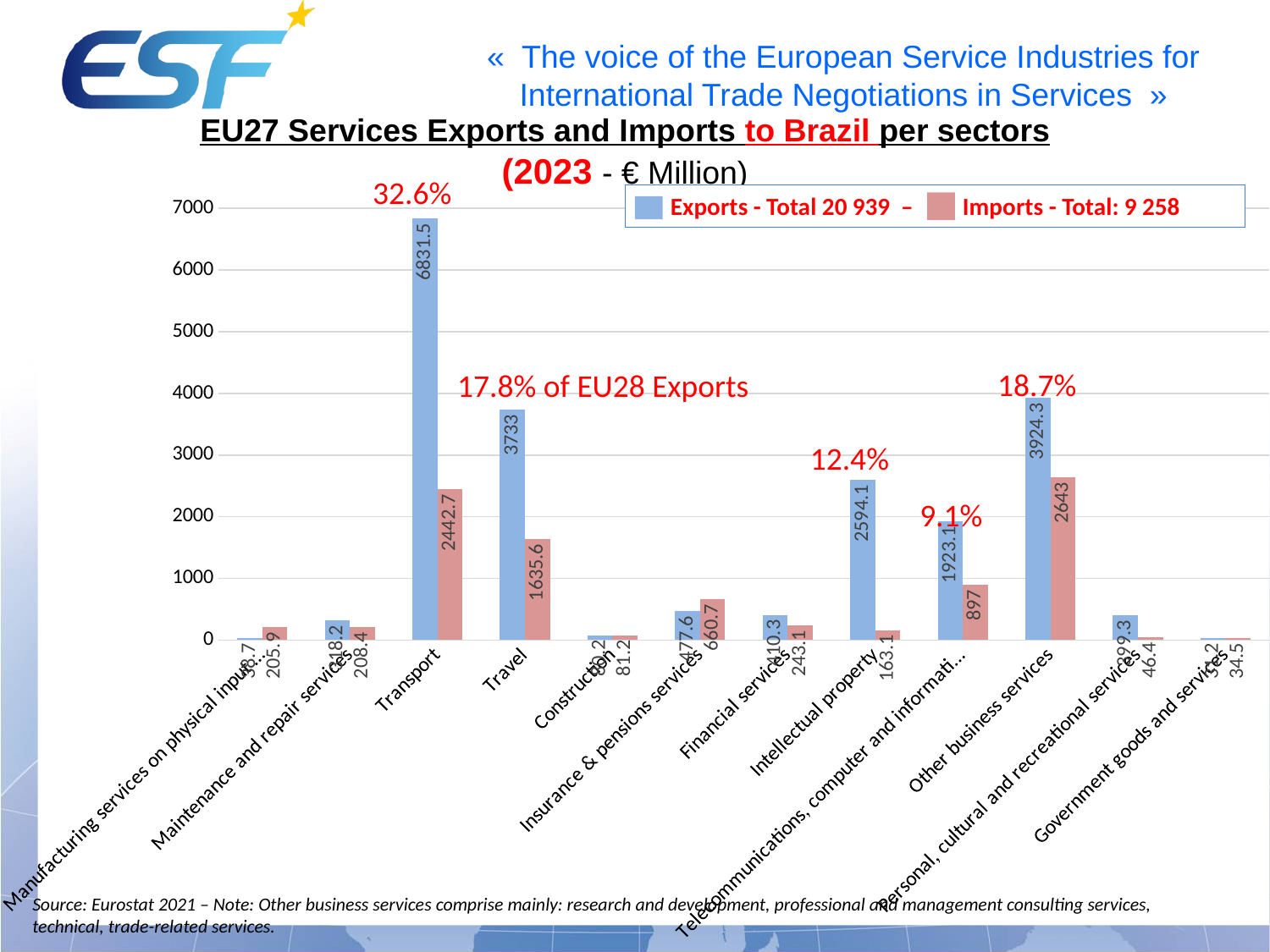
How many sector categories are plotted on the x axis? 12 Which sector has the highest imports value? Other business services According to the legend, what is the total of exports? 20 939 Which sector has the highest exports value? Transport Is the exports value for Telecommunications, computer and information services greater or less than 1000? greater How many series does the legend list? 2 What kind of chart is shown on the slide? bar chart What is the value of imports for Travel? 1635.6 What is the value of imports for Other business services? 2643 For Insurance & pensions services, which is larger: exports or imports? Imports What is the value of EU27 services exports to Brazil for Transport? 6831.5 What is the difference between exports and imports for Transport? 4388.8